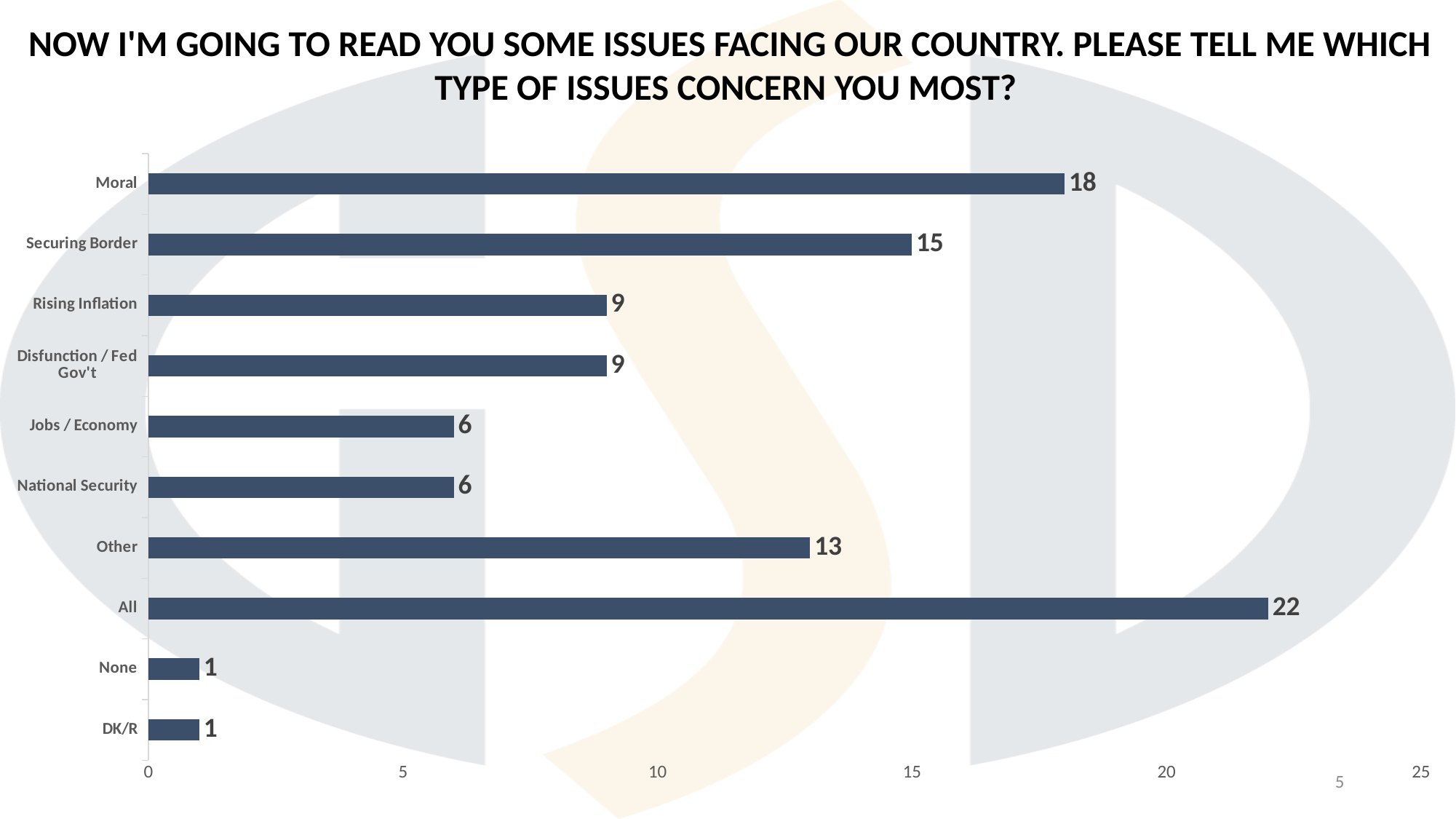
What is the value for Moral? 18 What is the difference between the values for All and Moral? 4 Which category has the highest value? All What is the difference between the values for Rising Inflation and Jobs / Economy? 3 Which is larger, the value for Securing Border or the value for Other? Securing Border Is the value for Moral greater or less than 15? greater What is the value for Other? 13 What is the highest value shown on the horizontal axis? 25 How many categories are shown in the chart? 10 What kind of chart is shown on the slide? bar chart What is the value for Securing Border? 15 What is the value for National Security? 6